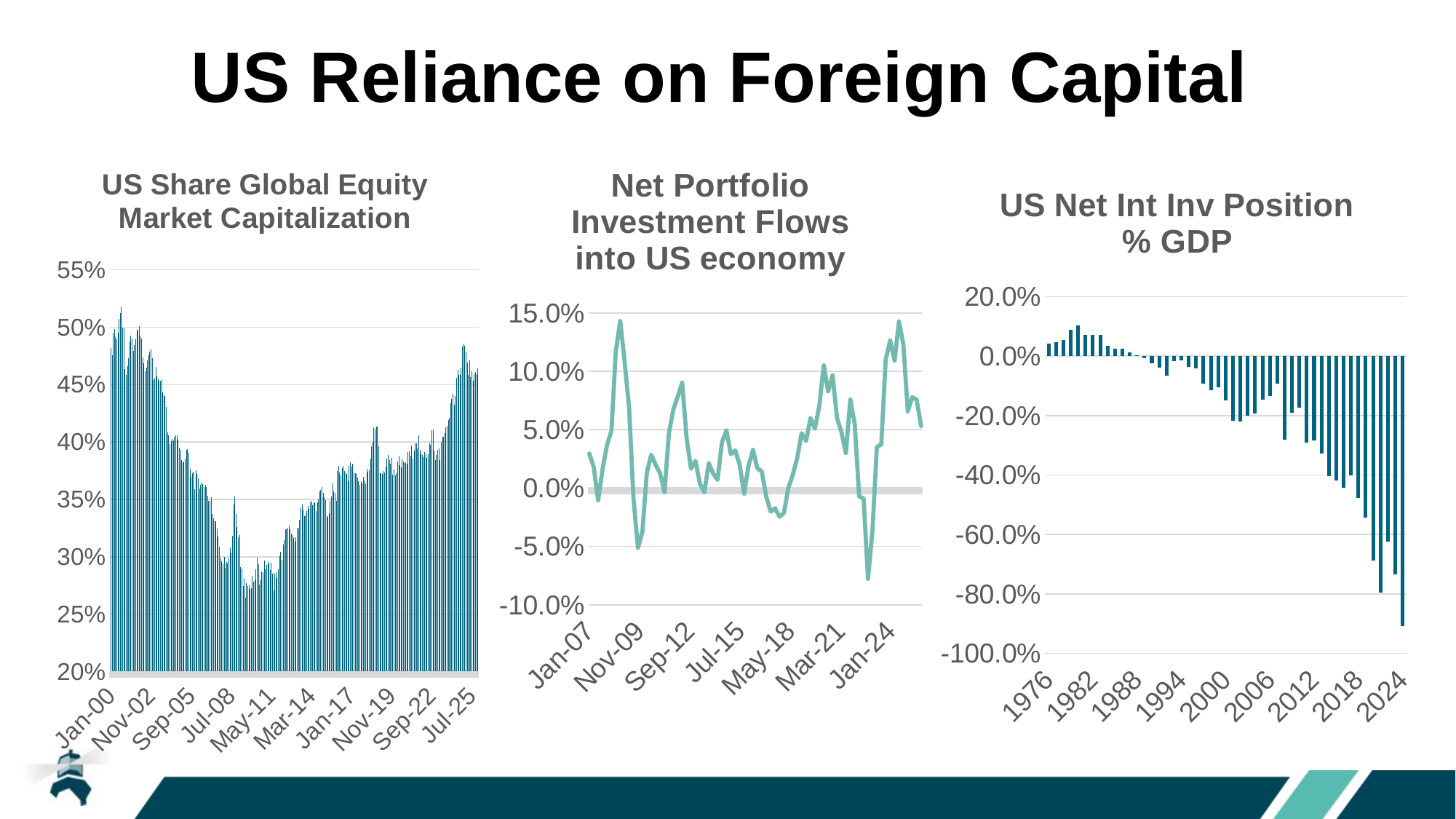
What kind of chart is the 'US Share Global Equity Market Capitalization' chart? bar chart In the 'US Share Global Equity Market Capitalization' chart, is the value at Jan-00 greater or less than 45%? greater In the 'US Net Int Inv Position % GDP' chart, is the value for 2024 greater or less than -80.0%? less In the 'US Share Global Equity Market Capitalization' chart, is the value around Jul-08 greater or less than 35%? less In the 'US Share Global Equity Market Capitalization' chart, do the values rise or fall between Jan-00 and Jul-08? fall In the 'US Net Int Inv Position % GDP' chart, do the values rise or fall from 1988 to 2024? fall How many charts are shown on the slide? 3 What kind of chart is the 'Net Portfolio Investment Flows into US economy' chart? line chart What kind of chart is the 'US Net Int Inv Position % GDP' chart? bar chart